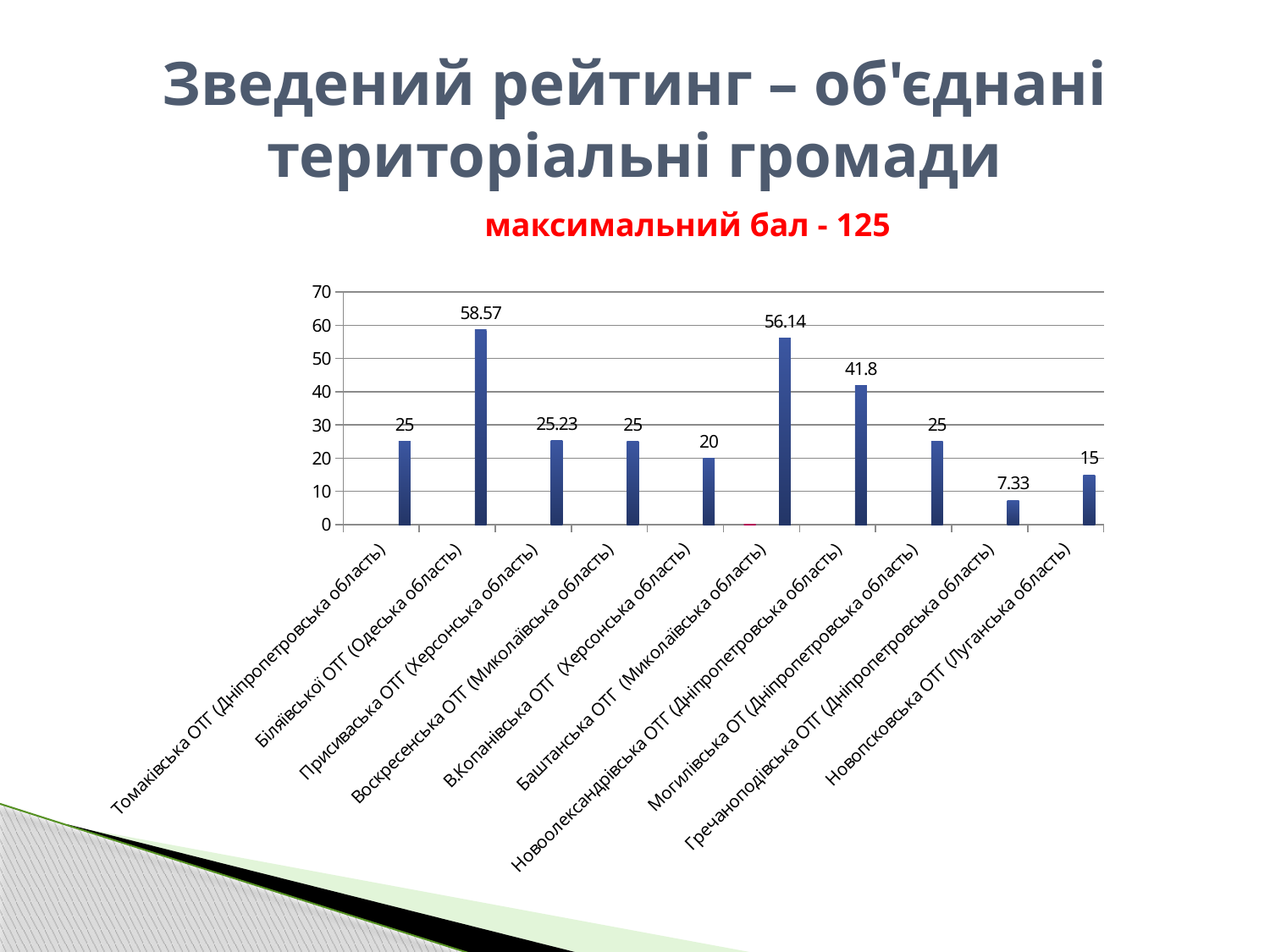
What is the value for Гречаноподівська ОТГ (Дніпропетровська область)? 7.33 What is the difference between the values for Біляївської ОТГ and Баштанська ОТГ? 2.43 Which category has the lowest value? Гречаноподівська ОТГ (Дніпропетровська область) What is the value for В.Копанівська ОТГ (Херсонська область)? 20 Which category has the highest value? Біляївської ОТГ (Одеська область) What is the value for Новоолександрівська ОТГ (Дніпропетровська область)? 41.8 What is the value for Баштанська ОТГ (Миколаївська область)? 56.14 What is the value for Біляївської ОТГ (Одеська область)? 58.57 What kind of chart is shown on the slide? bar chart How many categories are shown on the x axis? 10 Is the value for Новопсковська ОТГ (Луганська область) greater or less than 20? less Which is larger: the value for Баштанська ОТГ or Новоолександрівська ОТГ? Баштанська ОТГ